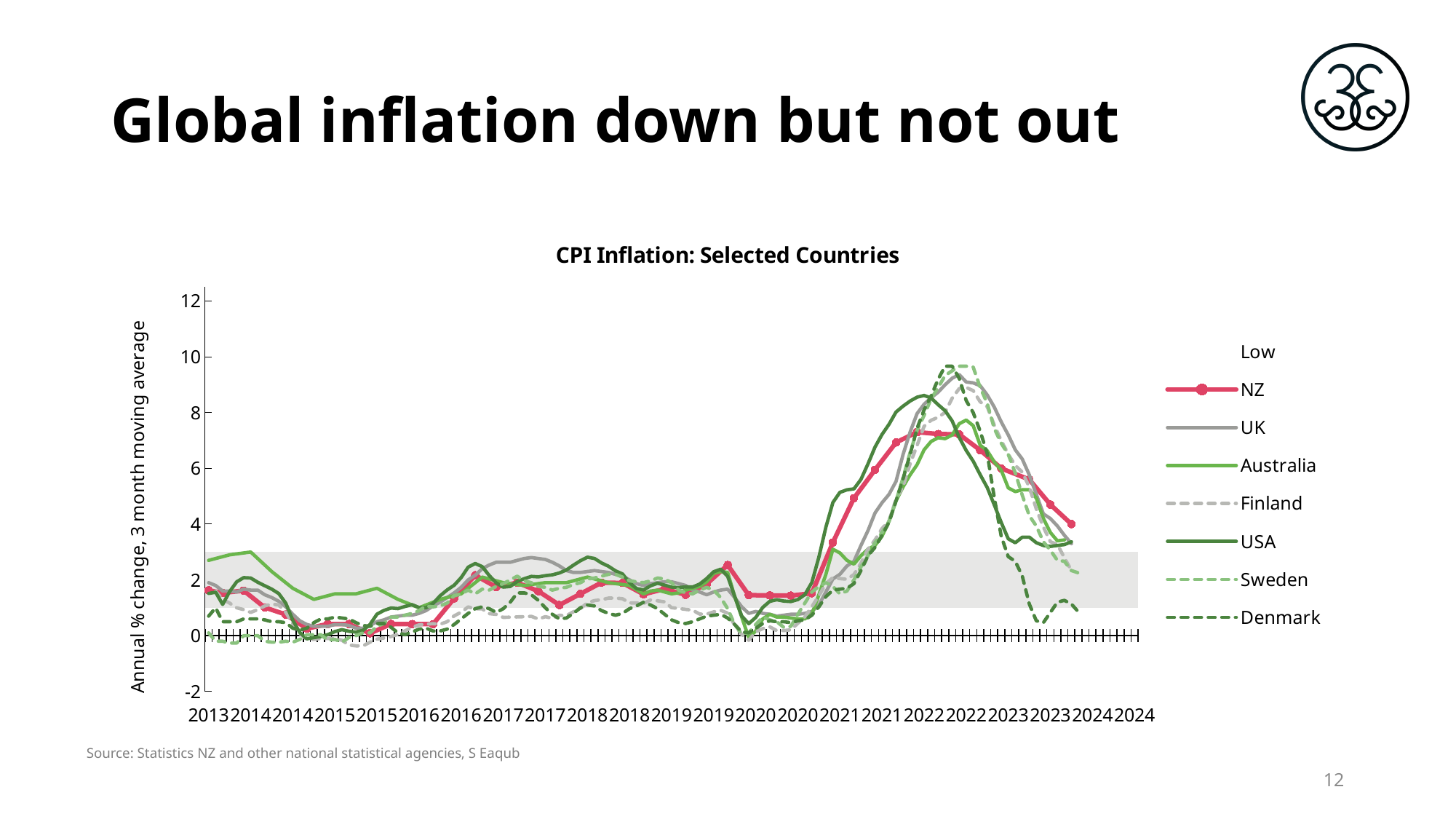
Is the value for NZ in 2020 greater or less than 4? less Does the NZ series rise or fall between its 2022 peak and the end of the series in 2023? fall Is the peak value for Denmark in 2022 greater or less than 8? greater Is the peak value for NZ in 2022 greater or less than 6? greater What is the title of the chart? CPI Inflation: Selected Countries How many entries does the chart's legend list? 8 Does the NZ series rise or fall between 2020 and 2022? rise What is the label on the vertical axis of the chart? Annual % change, 3 month moving average What kind of chart is shown on the slide? line chart Which series reaches a higher peak in 2022, NZ or Denmark? Denmark